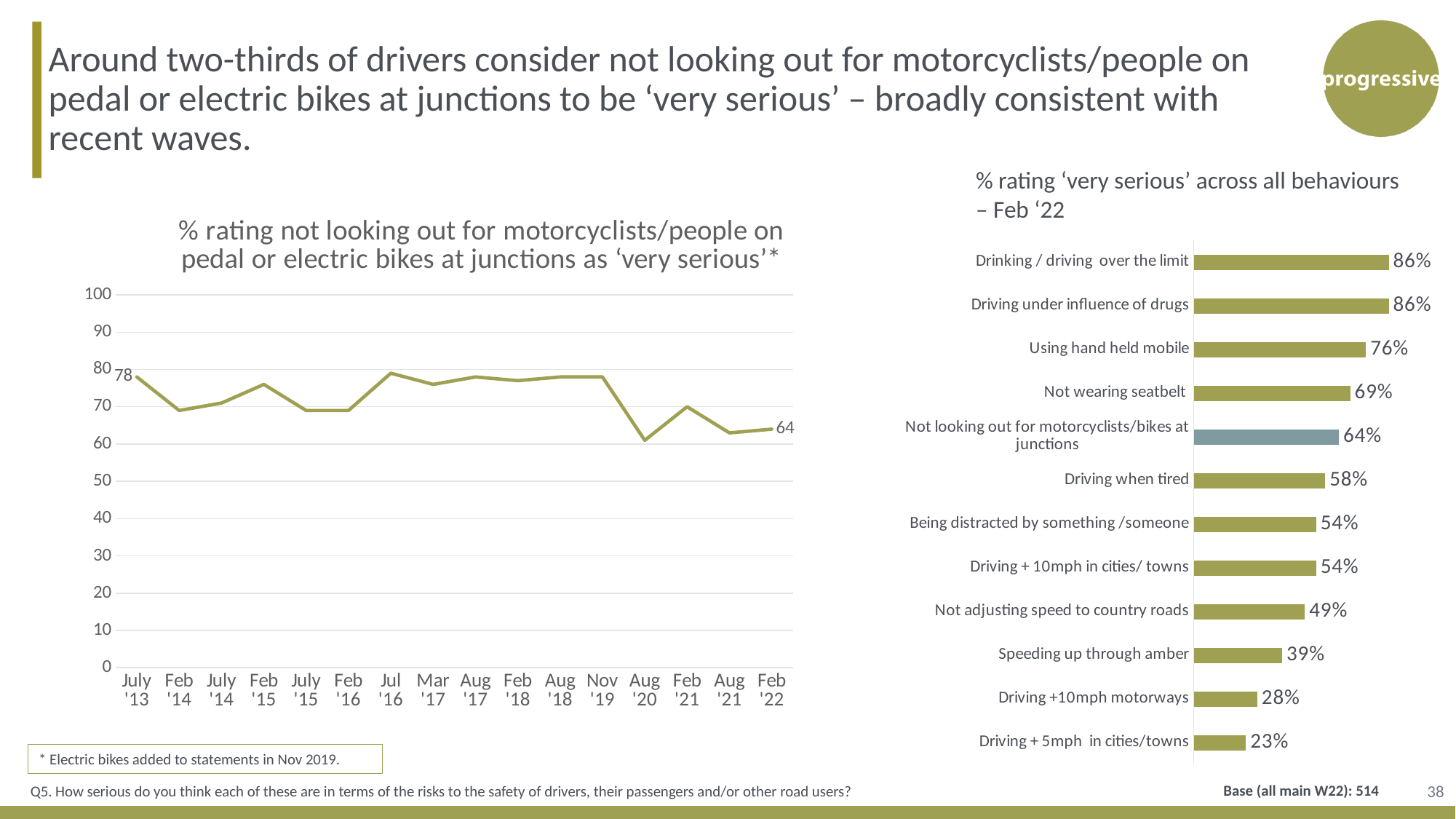
On the right bar chart, what is the value for Using hand held mobile? 76% On the right bar chart, which is larger: Not wearing seatbelt or Driving when tired? Not wearing seatbelt On the left line chart, what is the value for Feb '22? 64 What kind of chart is the chart on the left of the slide? line chart On the left line chart, what is the difference between the July '13 value and the Feb '22 value? 14 On the left line chart, how many time points are plotted along the x axis? 16 On the left line chart, what is the value for July '13? 78 On the right bar chart, which behaviour has the lowest % rating 'very serious'? Driving + 5mph in cities/towns On the right bar chart, which behaviour's bar is shown in a different colour from the others? Not looking out for motorcyclists/bikes at junctions On the left line chart, is the value for Aug '20 greater or less than 70? less On the right bar chart, how many behaviours are listed? 12 On the right bar chart, what is the difference between Driving under influence of drugs and Using hand held mobile? 10%